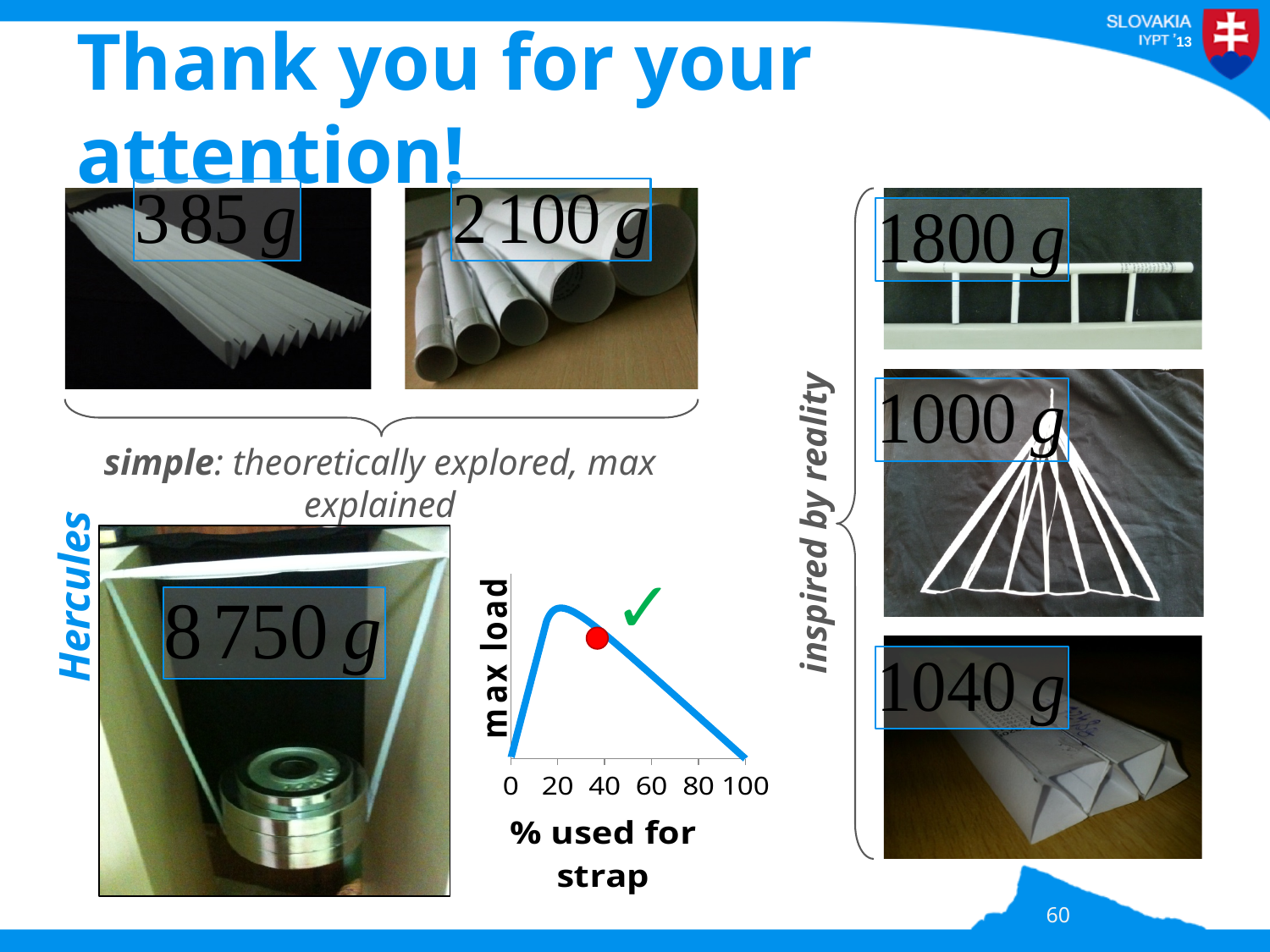
What kind of chart is shown at the bottom centre of the slide? line chart Is the x value at which the curve reaches its peak greater or less than 40? less Is the x value of the red dot on the curve greater or less than 60? less Does the curve rise or fall as the x axis goes from 40 to 100? fall How many tick values are printed on the x axis of the chart? 6 What is the label of the y axis of the chart? max load What is the smallest tick value shown on the x axis of the chart? 0 How many curves are plotted on the chart? 1 Is the x value of the red dot on the curve greater or less than 20? greater Does the curve rise or fall as the x axis goes from 0 to 20? rise What is the largest tick value shown on the x axis of the chart? 100 What is the label of the x axis of the chart? % used for strap